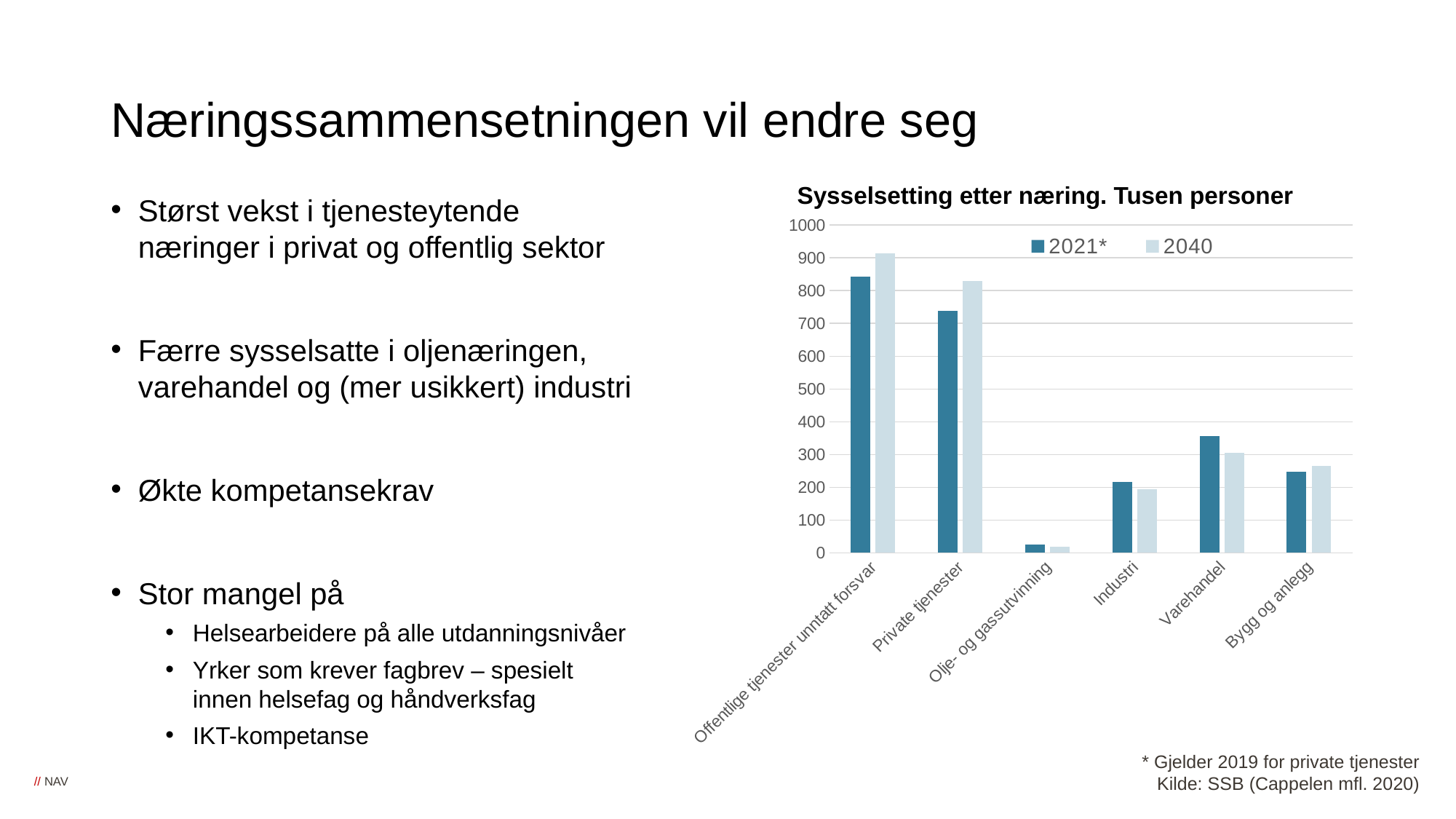
Is the 2040 value for Offentlige tjenester unntatt forsvar greater or less than 800? greater Is the 2040 value for Private tjenester greater or less than 800? greater How many series does the legend of the chart list? 2 For Bygg og anlegg, which series has the larger value, 2021* or 2040? 2040 Is the 2021* value for Industri greater or less than 300? less Which category has the lowest value for the 2040 series? Olje- og gassutvinning What are the two series named in the chart legend? 2021* and 2040 How many industry categories are shown on the x axis of the chart? 6 What is the title of the chart? Sysselsetting etter næring. Tusen personer For Varehandel, which series has the larger value, 2021* or 2040? 2021* What kind of chart is shown on the slide? Bar chart Which category has the highest value for the 2021* series? Offentlige tjenester unntatt forsvar